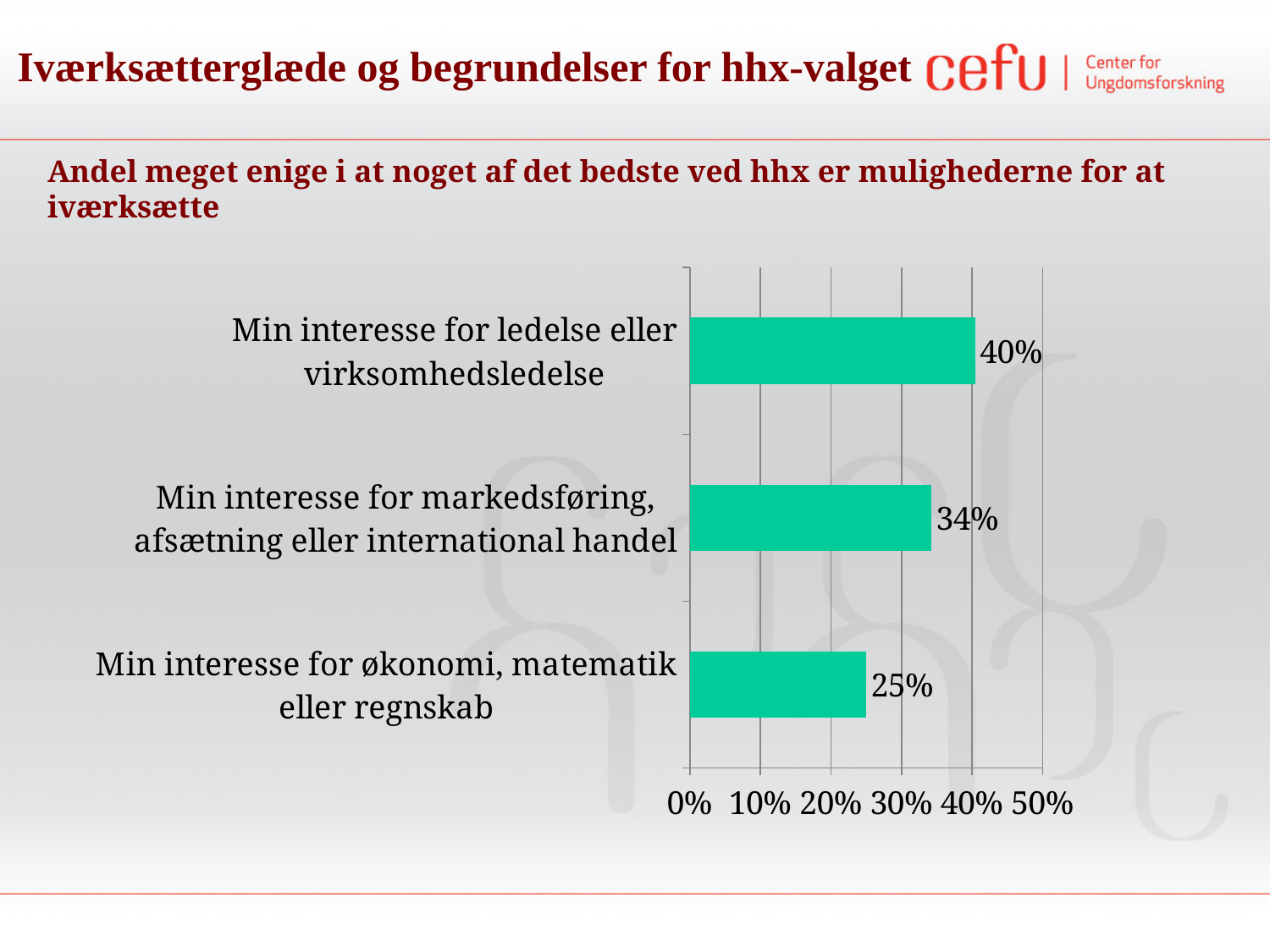
What is the maximum value shown on the x axis of the chart? 50% Is the value for "Min interesse for markedsføring, afsætning eller international handel" greater or less than 30%? greater Which category has the highest value? Min interesse for ledelse eller virksomhedsledelse What is the difference between the values for "Min interesse for ledelse eller virksomhedsledelse" and "Min interesse for økonomi, matematik eller regnskab"? 15% Which is larger: the value for "Min interesse for markedsføring, afsætning eller international handel" or for "Min interesse for økonomi, matematik eller regnskab"? Min interesse for markedsføring, afsætning eller international handel What is the value for "Min interesse for markedsføring, afsætning eller international handel"? 34% What kind of chart is shown on the slide? Bar chart What is the value for "Min interesse for økonomi, matematik eller regnskab"? 25% How many categories are shown in the chart? 3 Which category has the lowest value? Min interesse for økonomi, matematik eller regnskab What is the difference between the values for "Min interesse for markedsføring, afsætning eller international handel" and "Min interesse for økonomi, matematik eller regnskab"? 9% What is the value for "Min interesse for ledelse eller virksomhedsledelse"? 40%